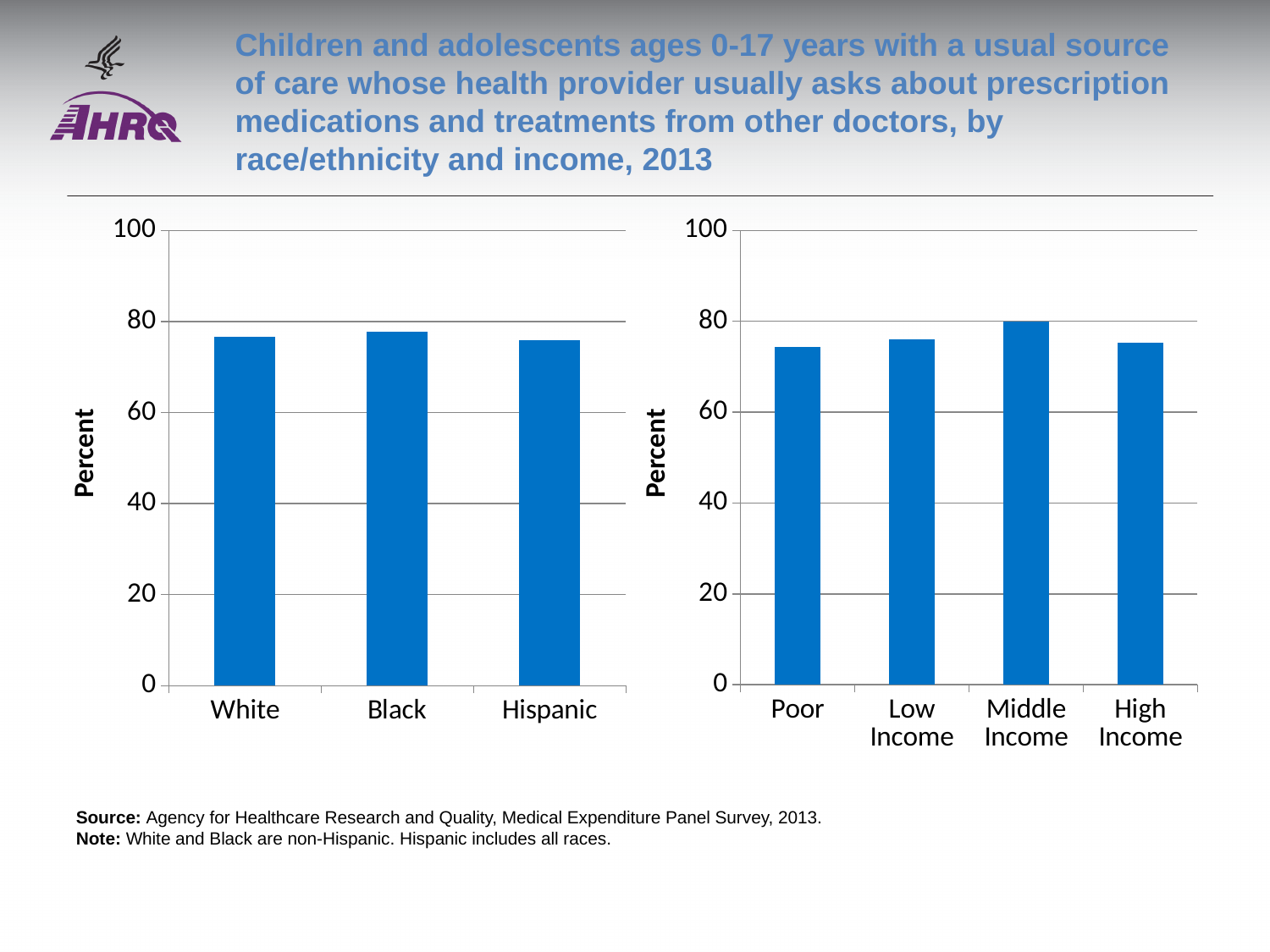
On the left chart (by race/ethnicity), how many categories are shown on the x axis? 3 What is the highest value shown on the y axis of the left chart (by race/ethnicity)? 100 On the left chart (by race/ethnicity), is the value for White greater or less than 80? less On the left chart (by race/ethnicity), is the value for Hispanic greater or less than 60? greater On the left chart (by race/ethnicity), is the value for Black greater or less than 60? greater What kind of chart is the left chart (by race/ethnicity)? Bar chart What is the label on the y axis of the right chart (by income)? Percent On the right chart (by income), which income group has the highest value? Middle Income On the right chart (by income), how many categories are shown on the x axis? 4 On the right chart (by income), which is larger, the value for Middle Income or the value for Poor? Middle Income